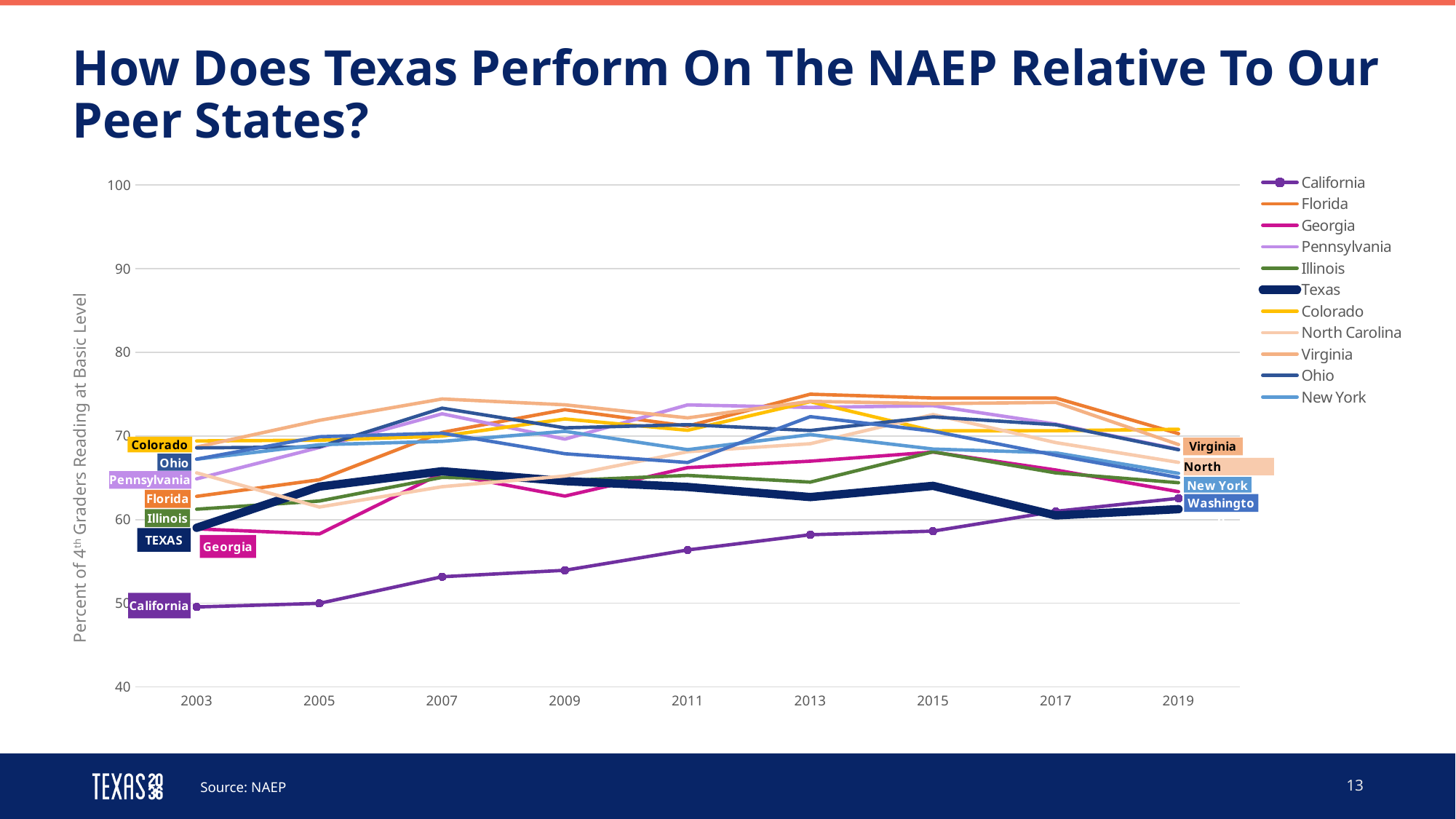
How many years are shown along the x axis? 9 Does the California line rise or fall from 2003 to 2019? rise Is the value for Texas in 2003 greater or less than 50? greater Is the value for Florida in 2013 greater or less than 70? greater What source is cited for the chart? NAEP What kind of chart is shown on the slide? line chart Is the value for California in 2003 greater or less than 60? less In 2003, which is larger: the value for Texas or the value for California? Texas How many series does the legend list? 11 Which state has the lowest value in 2003? California What is the label on the y axis? Percent of 4th Graders Reading at Basic Level